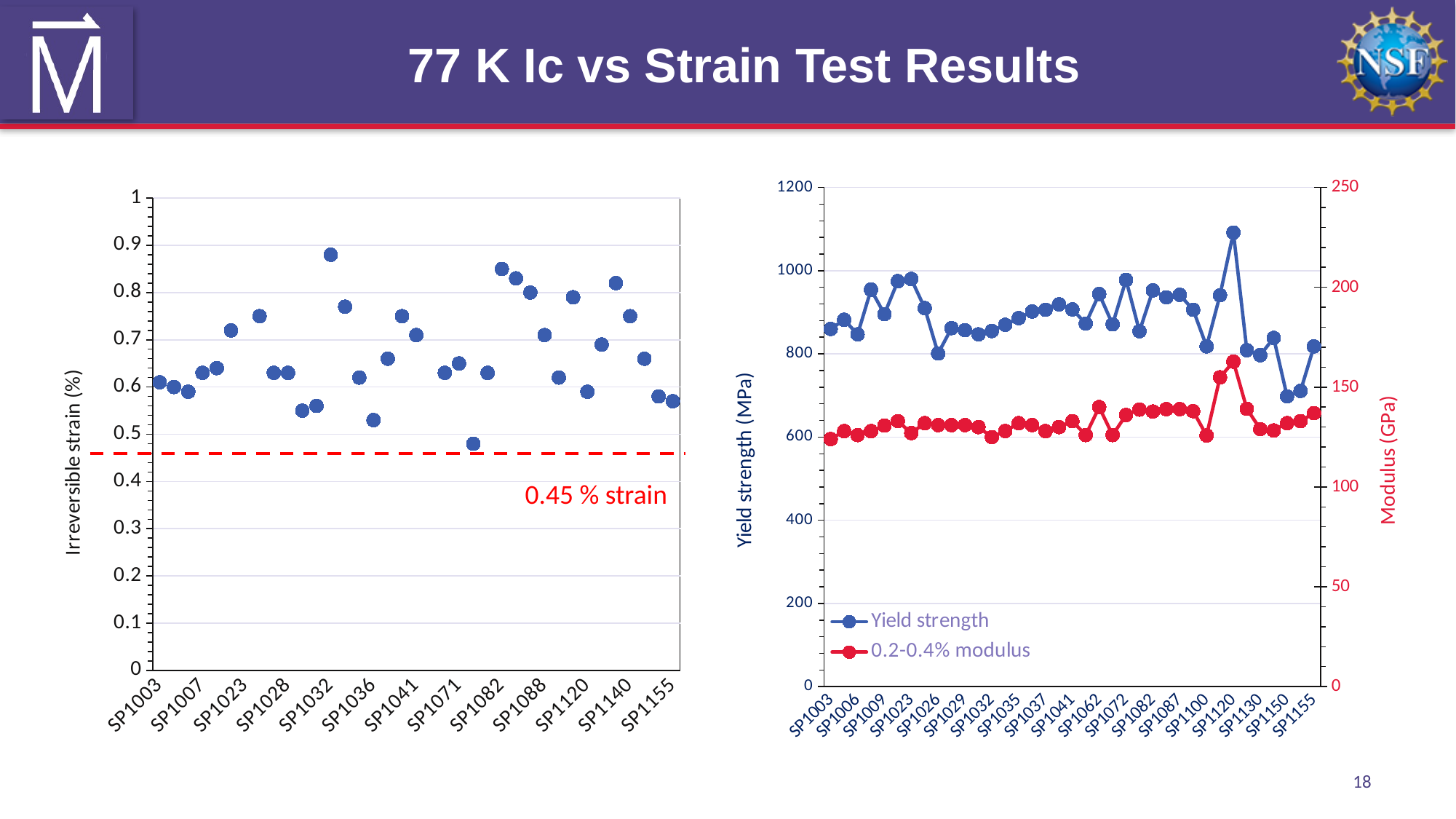
In the right chart, which is larger: the yield strength at SP1003 or the peak yield strength at SP1120? SP1120 What kind of chart is the right chart showing yield strength and modulus? line chart In the right chart, is the yield strength for SP1003 greater or less than 800? greater In the left chart, is the highest irreversible strain value greater or less than 0.8? greater In the right chart, is the highest yield strength value greater or less than 1000? greater In the left chart, what value does the red dashed line mark? 0.45 % strain How many series does the legend of the right chart list? 2 In the right chart, what are the two series named in the legend? Yield strength and 0.2-0.4% modulus What kind of chart is the left chart showing irreversible strain? scatter chart